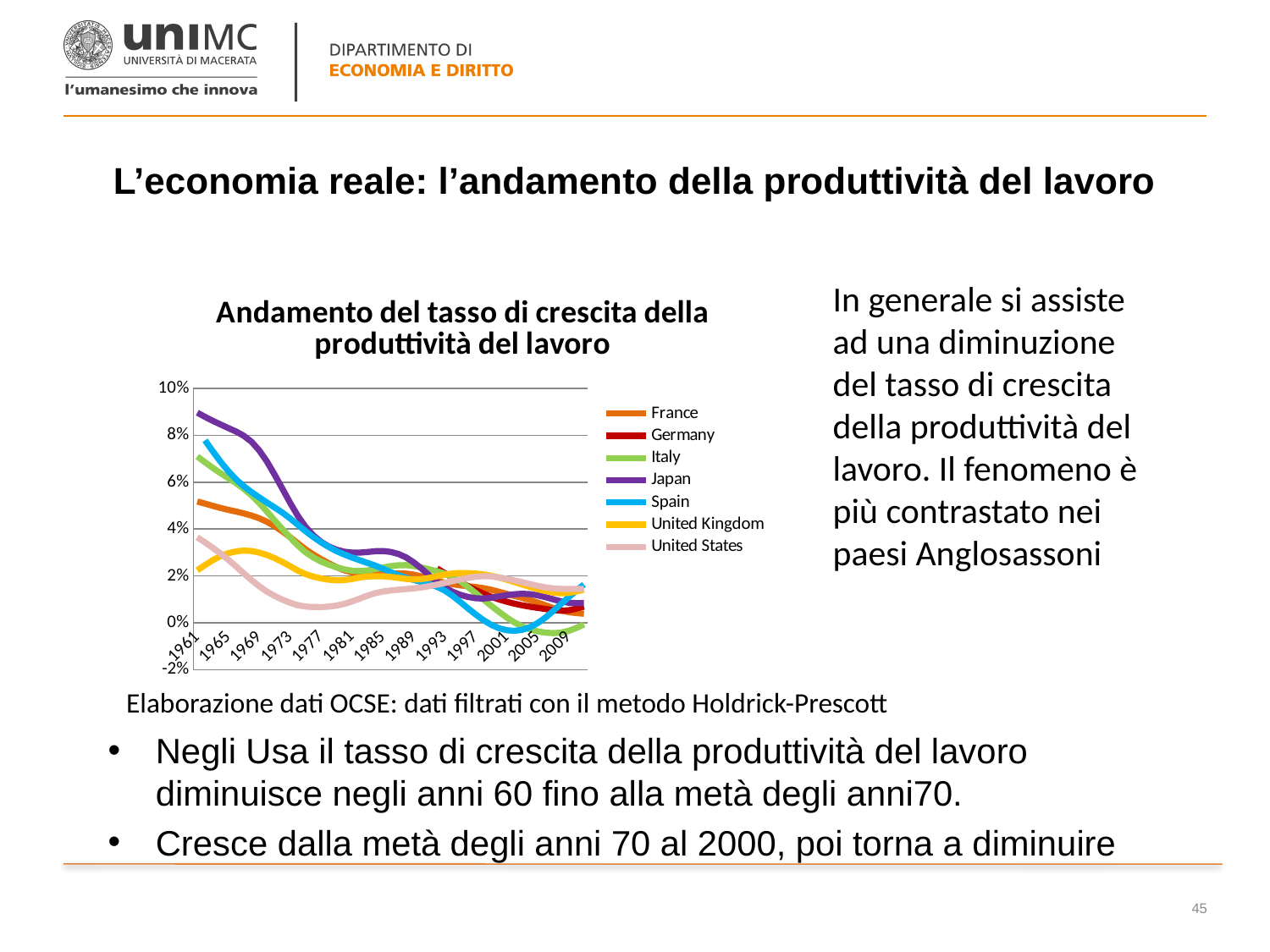
Which country has the lowest productivity growth rate in 1961? United Kingdom Which country has the highest productivity growth rate in 1961? Japan Which country has the lowest value in 2009? Italy What is the title of the chart? Andamento del tasso di crescita della produttività del lavoro Is the value for the United Kingdom in 1961 greater or less than 4%? less How many series does the chart's legend list? 7 Is the value for Japan in 1961 greater or less than 8%? greater In 1961, which is higher: the value for France or the value for Italy? Italy What is the highest value shown on the vertical axis? 10% Is the value for Spain in 2001 greater or less than 2%? less Does the value for Japan rise or fall from 1961 to 2009? fall What kind of chart is shown on the slide? line chart